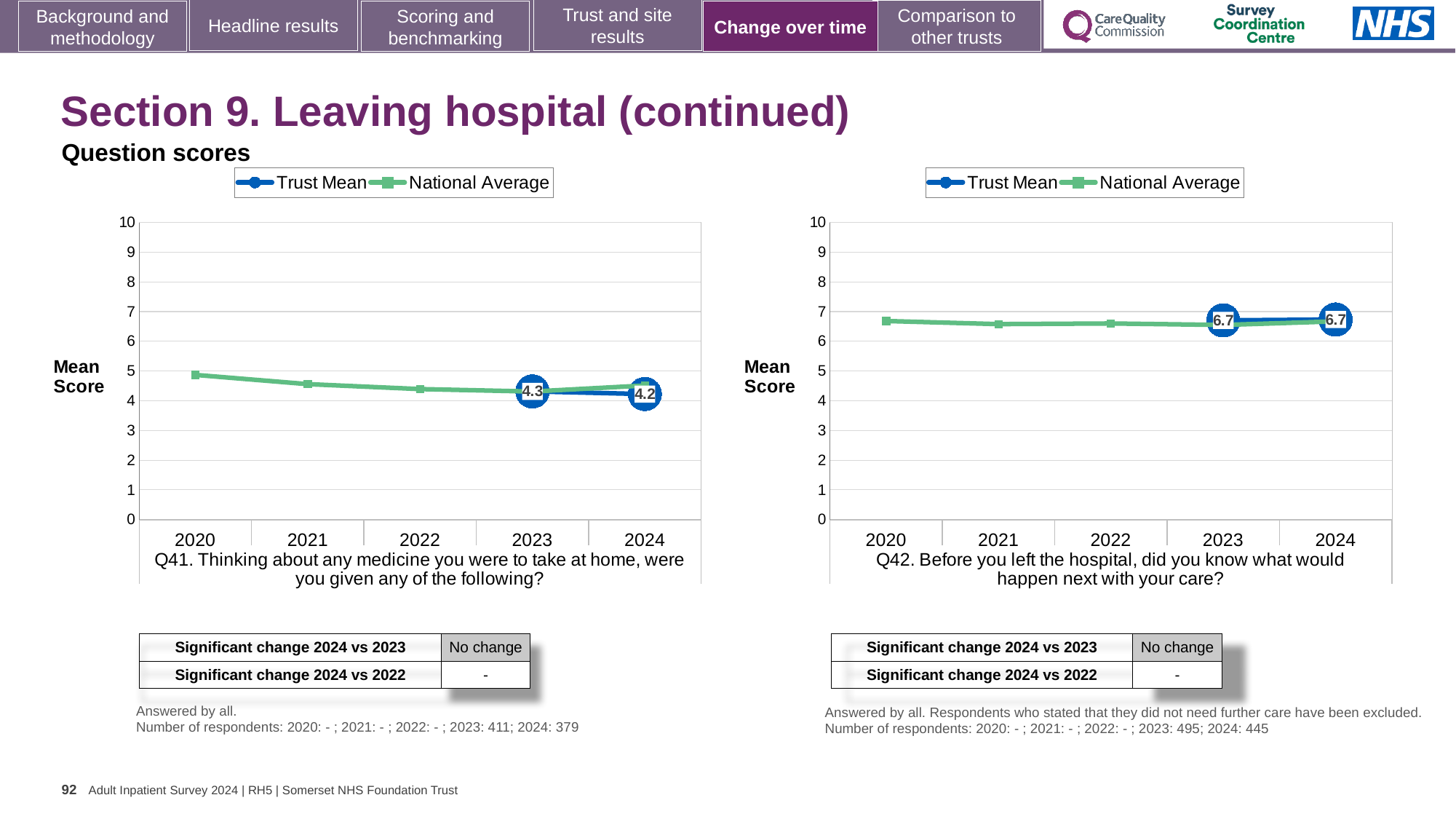
In the Q42 chart on the right, what is the Trust Mean value for 2024? 6.7 In the Q42 chart on the right, what is the Trust Mean value for 2023? 6.7 In the Q41 chart on the left, which year has the higher Trust Mean value, 2023 or 2024? 2023 In the Q41 chart on the left, is the National Average value for 2020 greater or less than 4? greater How many years are shown on the x axis of the Q42 chart on the right? 5 What kind of chart is the Q42 chart on the right? line chart How many series does the legend of the Q41 chart on the left list? 2 In the Q41 chart on the left, what is the Trust Mean value for 2024? 4.2 In the Q42 chart on the right, is the National Average value for 2021 greater or less than 7? less In the Q41 chart on the left, what is the Trust Mean value for 2023? 4.3 In the Q41 chart on the left, does the Trust Mean rise or fall from 2023 to 2024? fall In the Q41 chart on the left, what is the difference between the Trust Mean values for 2023 and 2024? 0.1